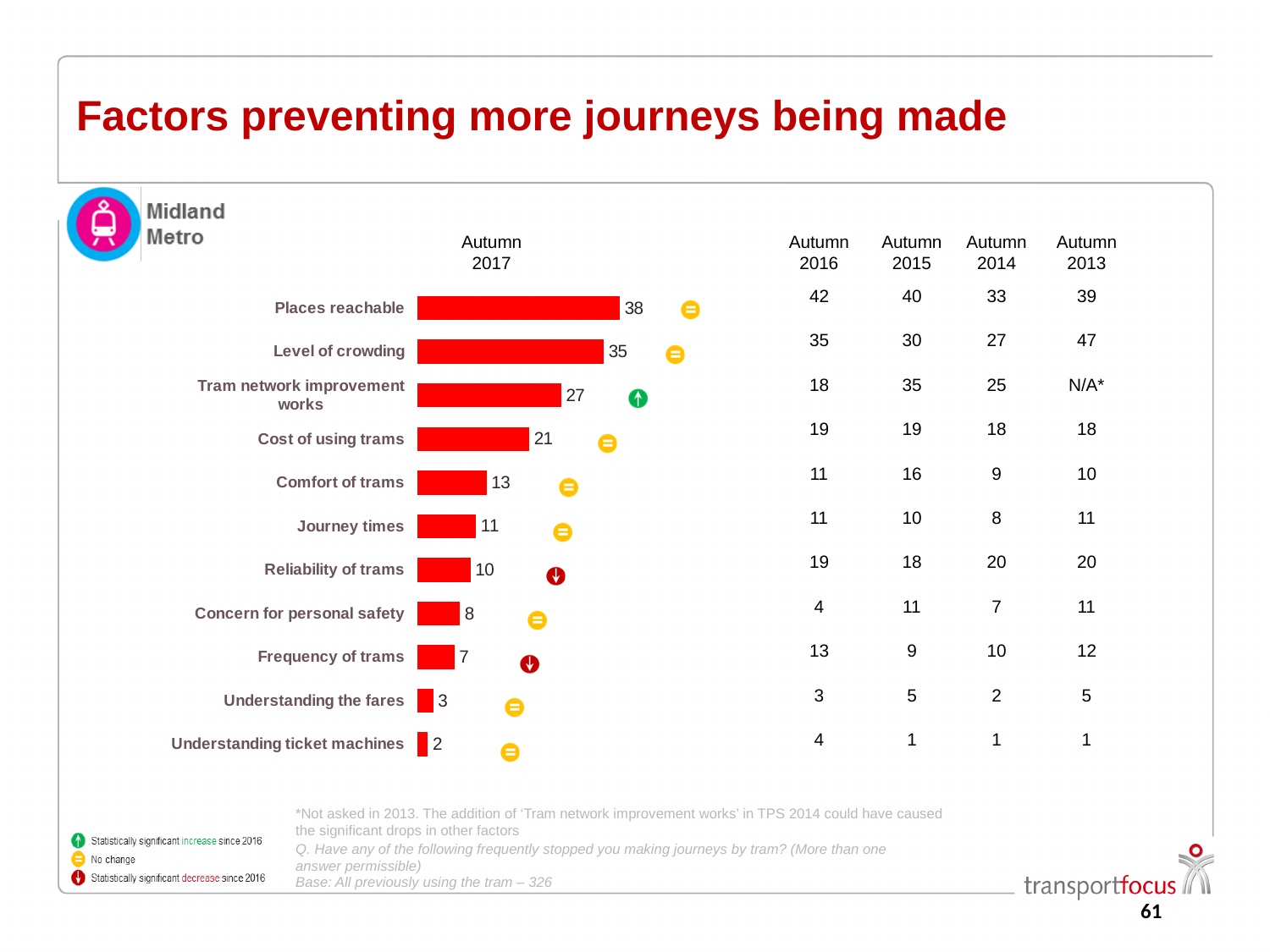
What is the difference between the Autumn 2017 values for Places reachable and Level of crowding? 3 What is the Autumn 2017 value for Cost of using trams? 21 Which factor has the lowest Autumn 2017 value in the bar chart? Understanding ticket machines Which factor has the highest Autumn 2017 value in the bar chart? Places reachable Which has a larger Autumn 2017 value, Comfort of trams or Reliability of trams? Comfort of trams What is the difference between the Autumn 2017 values for Tram network improvement works and Cost of using trams? 6 What type of chart is used to show the Autumn 2017 values? Bar chart What is the Autumn 2017 value for Frequency of trams? 7 How many factors are plotted in the Autumn 2017 bar chart? 11 Which has a larger Autumn 2017 value, Concern for personal safety or Understanding the fares? Concern for personal safety What is the Autumn 2017 value for Places reachable? 38 What is the title of the slide containing the bar chart? Factors preventing more journeys being made